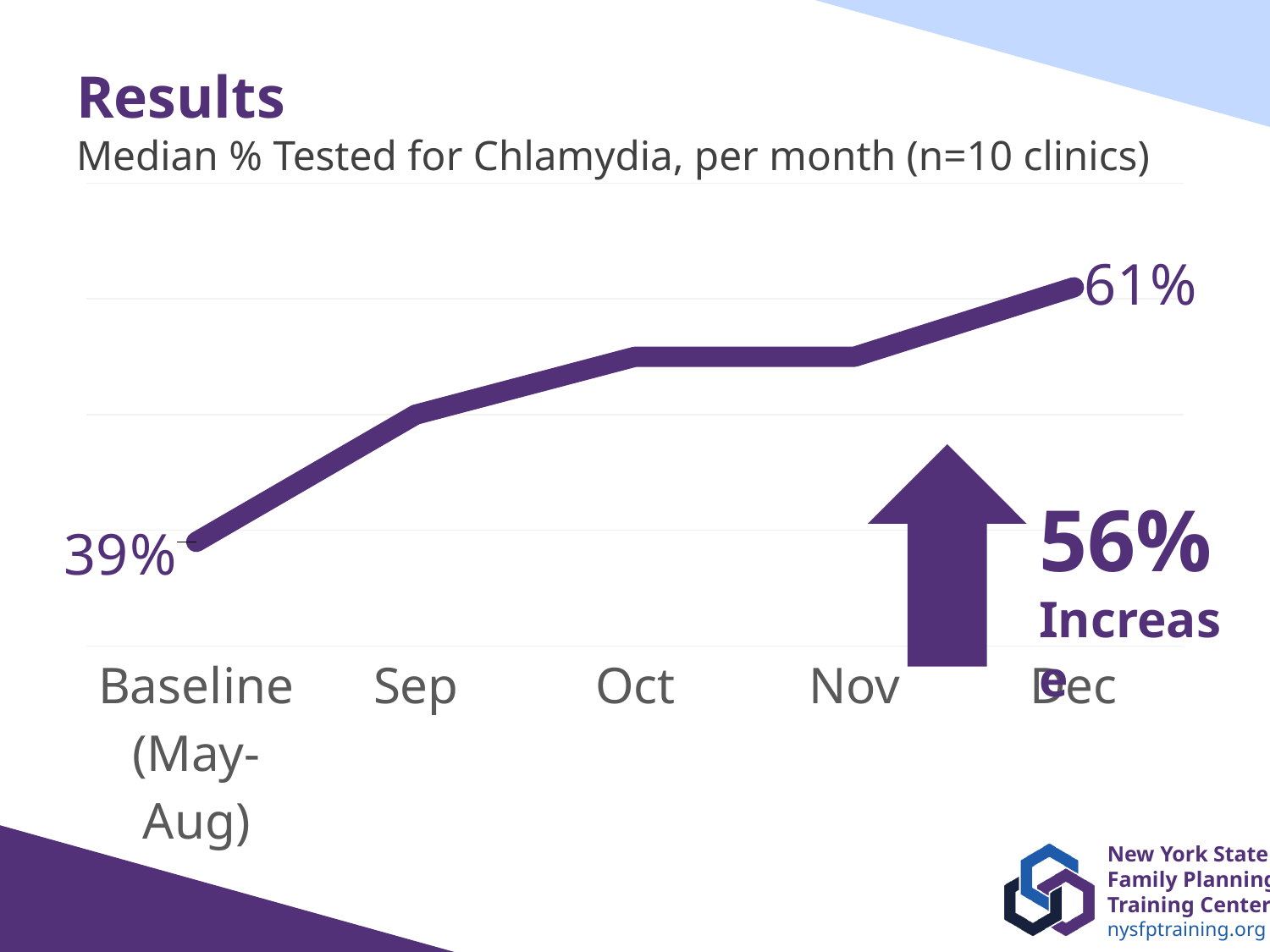
Which period has the lowest median % tested? Baseline (May-Aug) By how many percentage points did the median % tested rise from Baseline (May-Aug) to Dec? 22 Which is higher, the median % tested in Nov or in Dec? Dec What percentage increase does the annotation next to the arrow state? 56% Increase How many time periods are plotted on the x axis? 5 Does the median % tested rise or fall from Baseline to Dec? Rise How many clinics does the chart subtitle say are included? 10 Which month has the highest median % tested? Dec What is the median % tested for chlamydia at Baseline (May-Aug)? 39% Which is higher, the median % tested in Sep or in Oct? Oct What is the median % tested for chlamydia in Dec? 61% What kind of chart is shown on the slide? Line chart